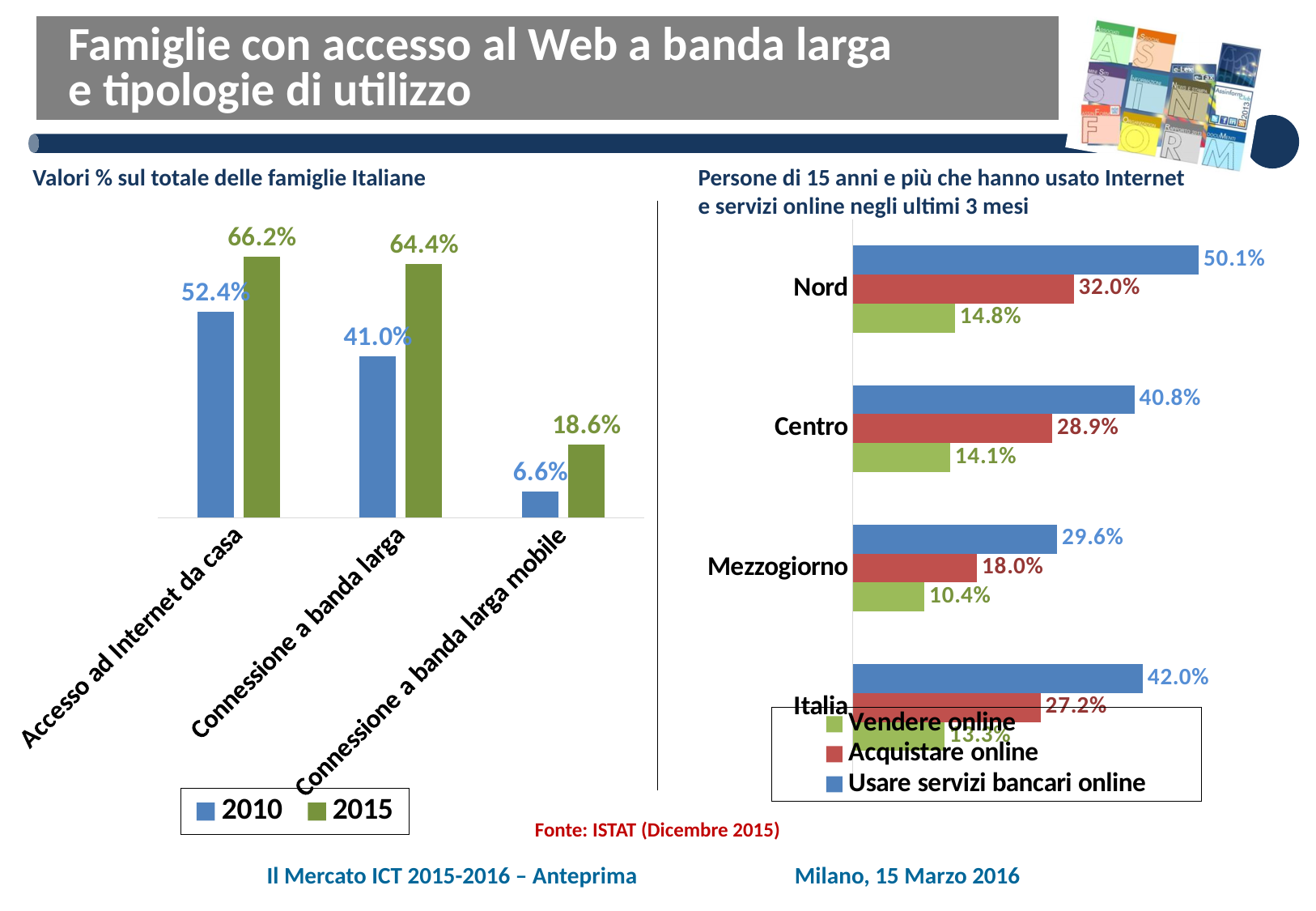
In the right chart (Persone di 15 anni e più che hanno usato Internet e servizi online negli ultimi 3 mesi), what is the value for Acquistare online in Mezzogiorno? 18.0% In the right chart (Persone di 15 anni e più che hanno usato Internet e servizi online negli ultimi 3 mesi), which colour represents Acquistare online? Red In the left chart (Valori % sul totale delle famiglie Italiane), what is the 2010 value for Connessione a banda larga mobile? 6.6% In the right chart (Persone di 15 anni e più che hanno usato Internet e servizi online negli ultimi 3 mesi), what is the value for Usare servizi bancari online in Nord? 50.1% What kind of chart is the left chart (Valori % sul totale delle famiglie Italiane)? Bar chart In the left chart (Valori % sul totale delle famiglie Italiane), by how many percentage points did Connessione a banda larga grow from 2010 to 2015? 23.4 percentage points In the right chart (Persone di 15 anni e più che hanno usato Internet e servizi online negli ultimi 3 mesi), how many regions are shown? 4 In the left chart (Valori % sul totale delle famiglie Italiane), what is the 2015 value for Accesso ad Internet da casa? 66.2% In the right chart (Persone di 15 anni e più che hanno usato Internet e servizi online negli ultimi 3 mesi), which region has the highest value for Vendere online? Nord In the left chart (Valori % sul totale delle famiglie Italiane), which category has the lowest 2015 value? Connessione a banda larga mobile In the left chart (Valori % sul totale delle famiglie Italiane), how many series does the legend list? 2 In the right chart (Persone di 15 anni e più che hanno usato Internet e servizi online negli ultimi 3 mesi), what is the difference between Usare servizi bancari online in Nord and in Centro? 9.3 percentage points